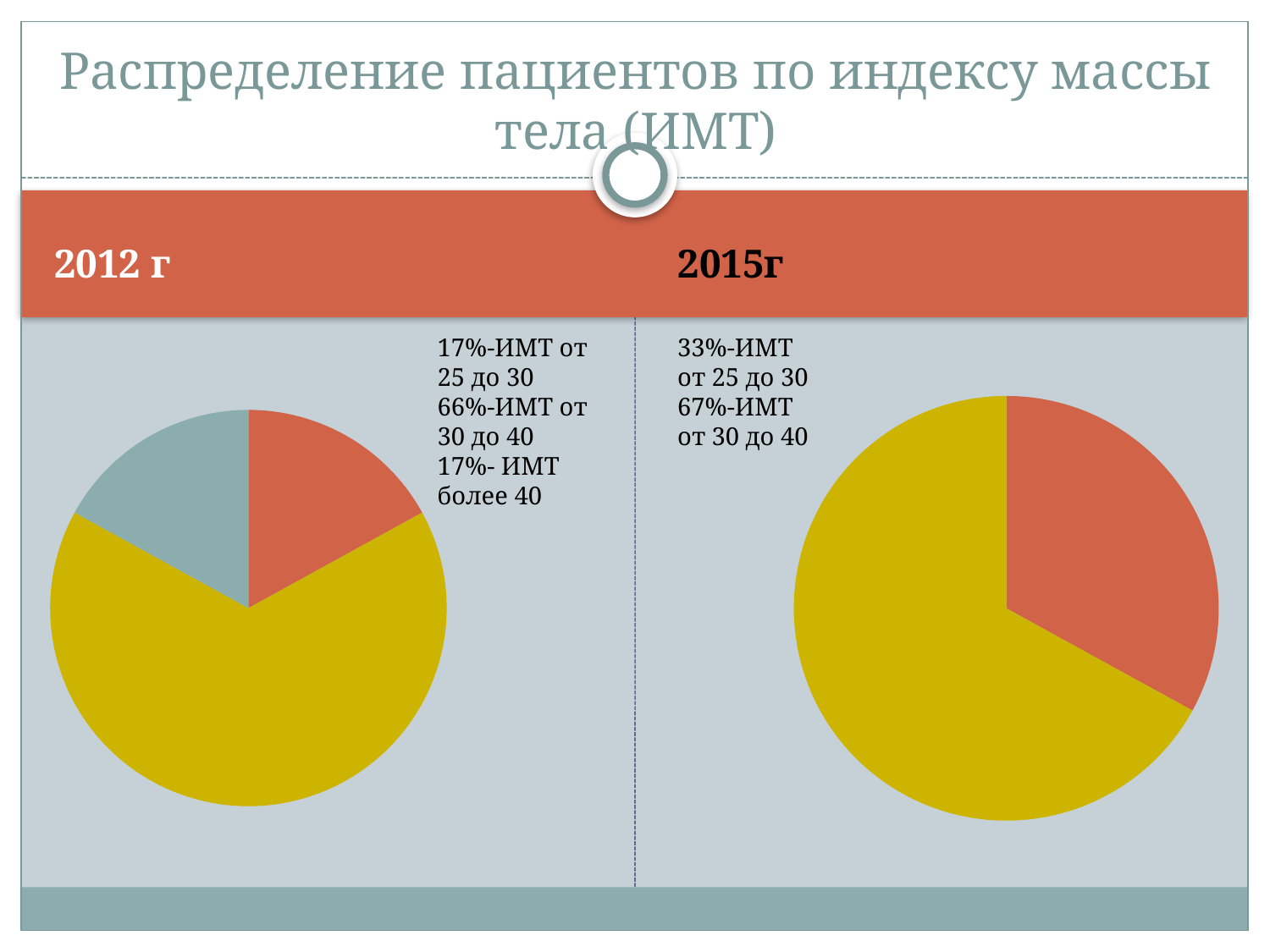
In the 2015г chart, what share of patients had ИМТ от 25 до 30? 33% In the 2012 г chart, what share of patients had ИМТ более 40? 17% What kind of chart is used for the 2012 г data? pie chart In the 2015г chart, which ИМТ group has the smallest share? ИМТ от 25 до 30 Which is larger: the share of ИМТ от 30 до 40 in 2012 г or in 2015г? 2015г In the 2012 г chart, which ИМТ group has the largest share? ИМТ от 30 до 40 How many slices does the 2015г pie chart have? 2 How many slices does the 2012 г pie chart have? 3 In the 2012 г pie chart, what colour is the largest slice? yellow What is the difference between the share of ИМТ от 25 до 30 in 2015г and in 2012 г? 16% In the 2015г chart, what share of patients had ИМТ от 30 до 40? 67%